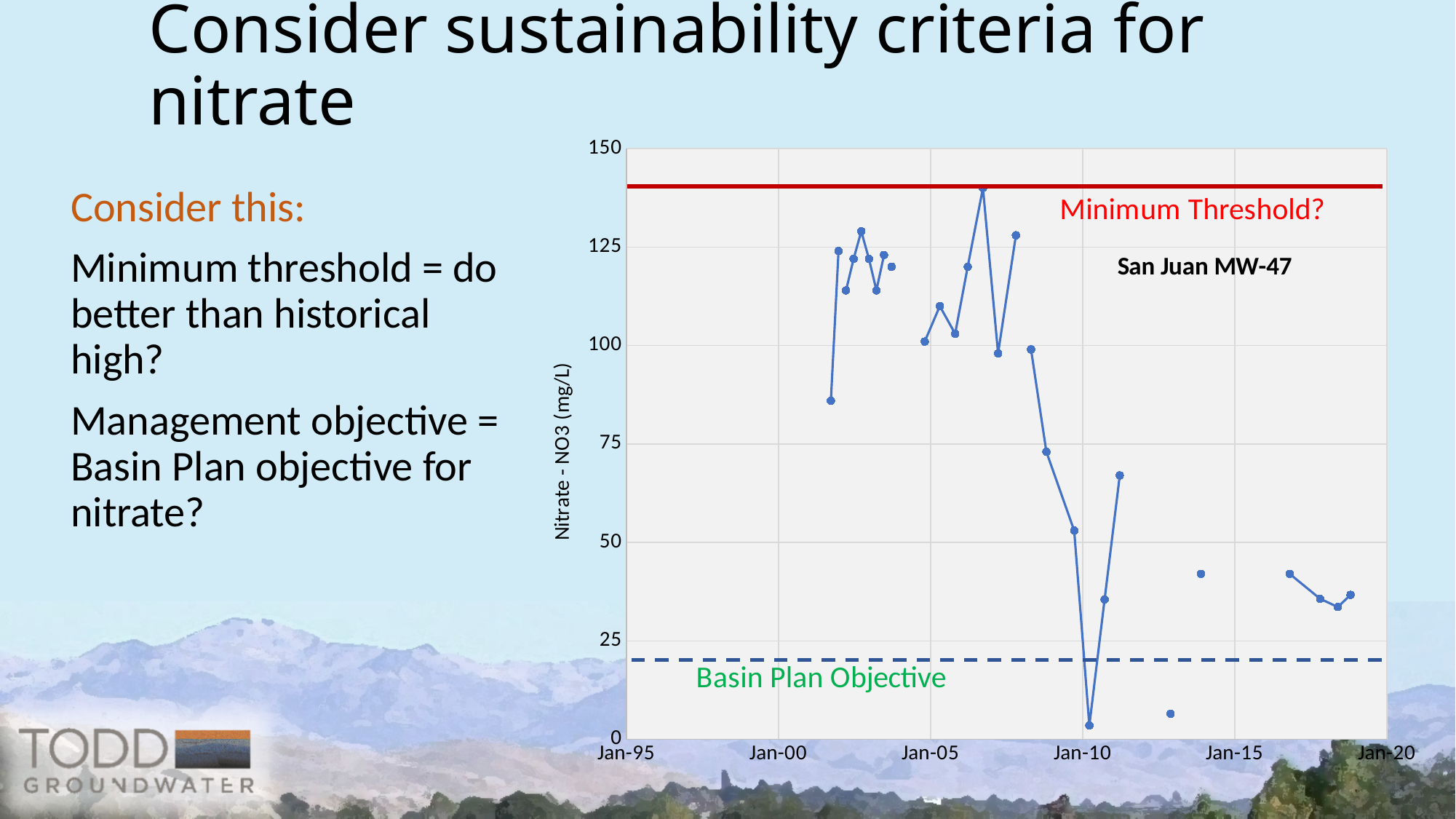
Between which two x-axis ticks does the highest nitrate value occur? Jan-05 and Jan-10 Overall, do the nitrate values rise or fall from the earliest to the latest measurements on the chart? fall What kind of chart is shown on the slide? Line chart Is the lowest nitrate value plotted on the chart greater or less than 25? less Is the first plotted nitrate value (just after Jan-00) greater or less than 75? greater What label is given to the solid red horizontal line on the chart? Minimum Threshold? What is the label of the y axis of the chart? Nitrate - NO3 (mg/L) Are the nitrate values plotted between Jan-15 and Jan-20 greater or less than 50? less Near which x-axis tick does the lowest nitrate value occur? Jan-10 Which is larger: the nitrate value plotted just after Jan-05 or the lowest value plotted near Jan-10? The value just after Jan-05